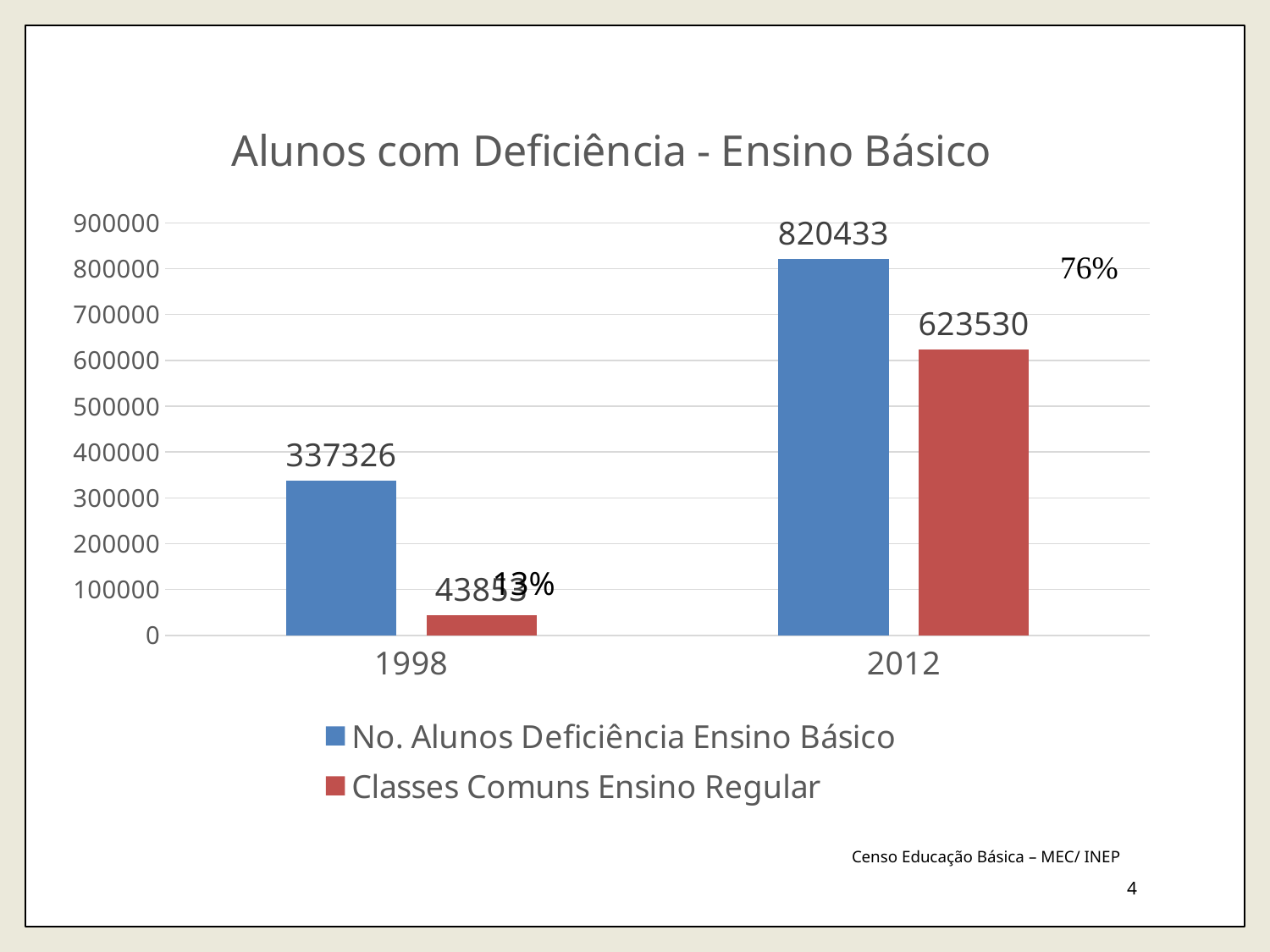
What is the value for No. Alunos Deficiência Ensino Básico in 1998? 337326 How many years are shown on the x axis? 2 What is the value for No. Alunos Deficiência Ensino Básico in 2012? 820433 In 2012, which is larger: No. Alunos Deficiência Ensino Básico or Classes Comuns Ensino Regular? No. Alunos Deficiência Ensino Básico What is the value for Classes Comuns Ensino Regular in 2012? 623530 What is the difference between No. Alunos Deficiência Ensino Básico and Classes Comuns Ensino Regular in 2012? 196903 What is the difference between the No. Alunos Deficiência Ensino Básico values for 2012 and 1998? 483107 How many series does the legend list? 2 Which year has the lowest value for Classes Comuns Ensino Regular? 1998 What kind of chart is shown on the slide? bar chart Which year has the highest value for No. Alunos Deficiência Ensino Básico? 2012 Is the value for Classes Comuns Ensino Regular in 1998 greater or less than 100000? less